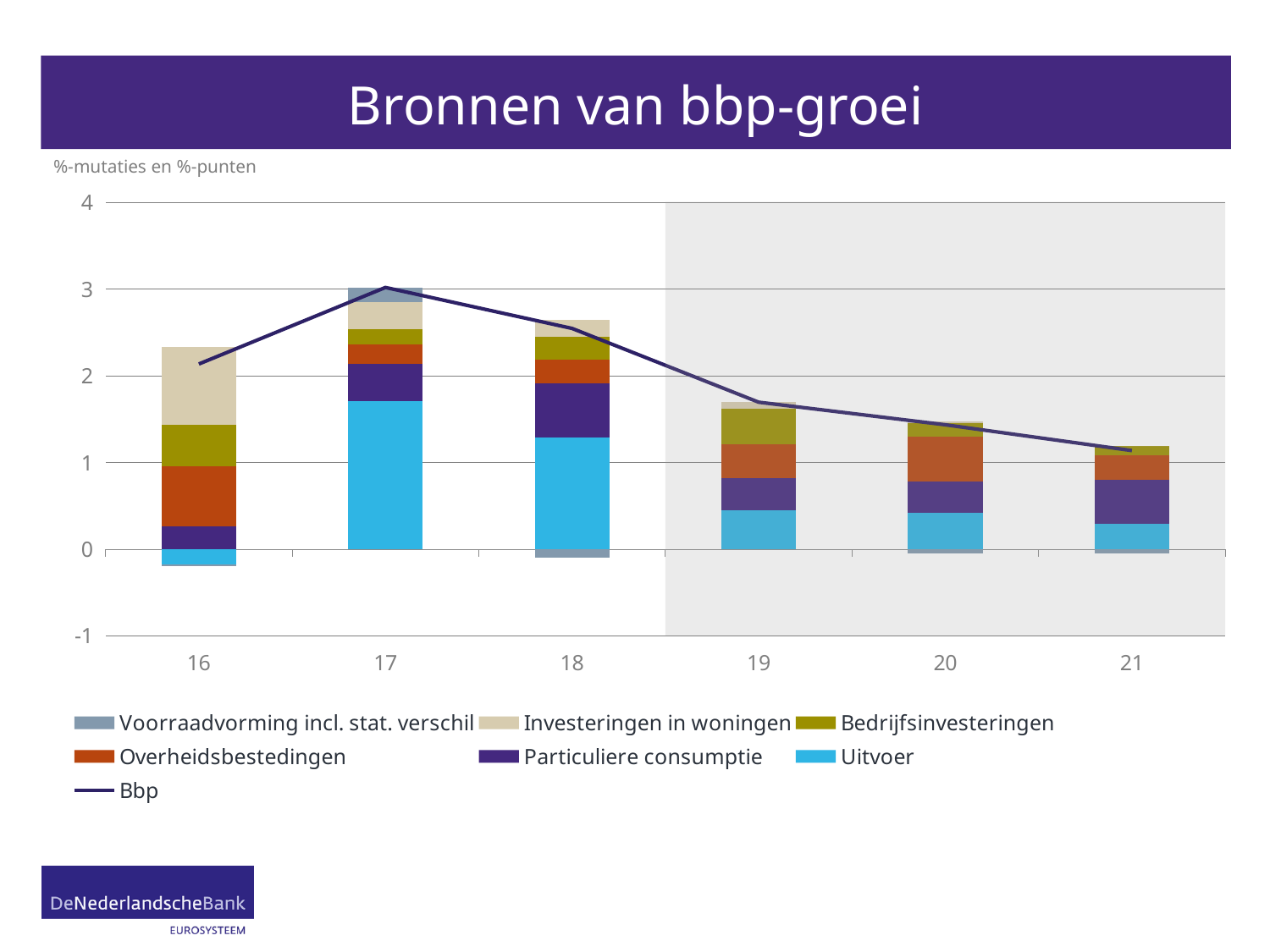
Does the Bbp line rise or fall from 17 to 21? fall What is the title of the chart? Bronnen van bbp-groei In which year does the Bbp line reach its highest value? 17 Which series is drawn as a line rather than as stacked bars? Bbp Is the Uitvoer contribution in 17 greater or less than 1? greater How many series does the legend list? 7 In which year is the Bbp line at its lowest value? 21 Is the Bbp value for 17 greater or less than 2? greater What kind of chart is shown on the slide? Stacked bar chart with a line How many years (categories) are shown on the x axis? 6 Which year has the larger Bbp value, 17 or 21? 17 Is the Bbp value for 19 greater or less than 2? less